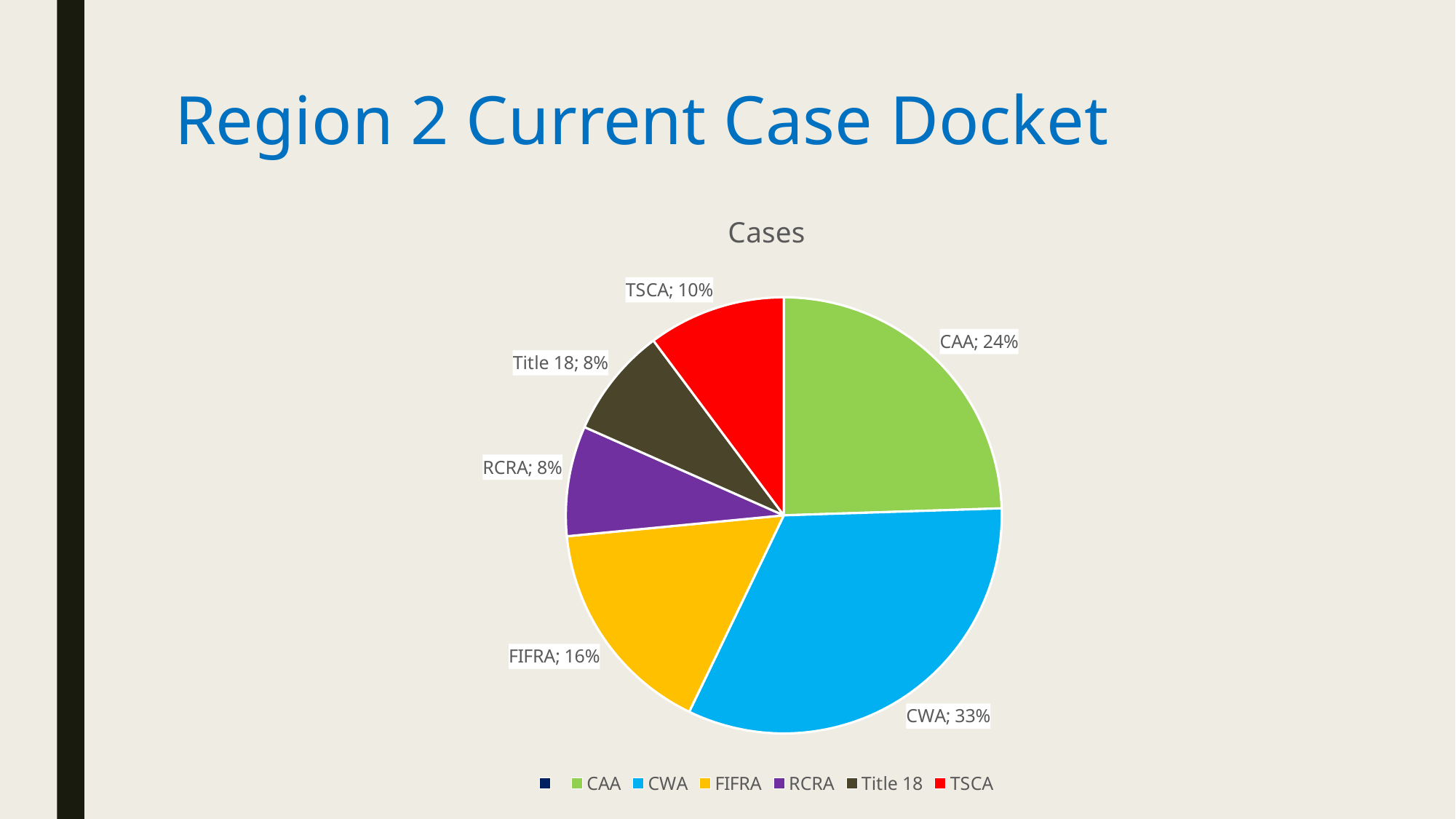
What percentage of cases is CAA? 24% What percentage of cases is Title 18? 8% What is the difference in percentage points between CWA and CAA? 9 How many labeled slices does the pie chart have? 6 What type of chart is shown on the slide? pie chart What is the title of the chart? Cases Which is larger, the share for FIFRA or the share for TSCA? FIFRA What percentage of cases is CWA? 33% Which category has the largest share of cases? CWA What percentage of cases is TSCA? 10% What percentage of cases is FIFRA? 16% What colour is the CWA slice? blue